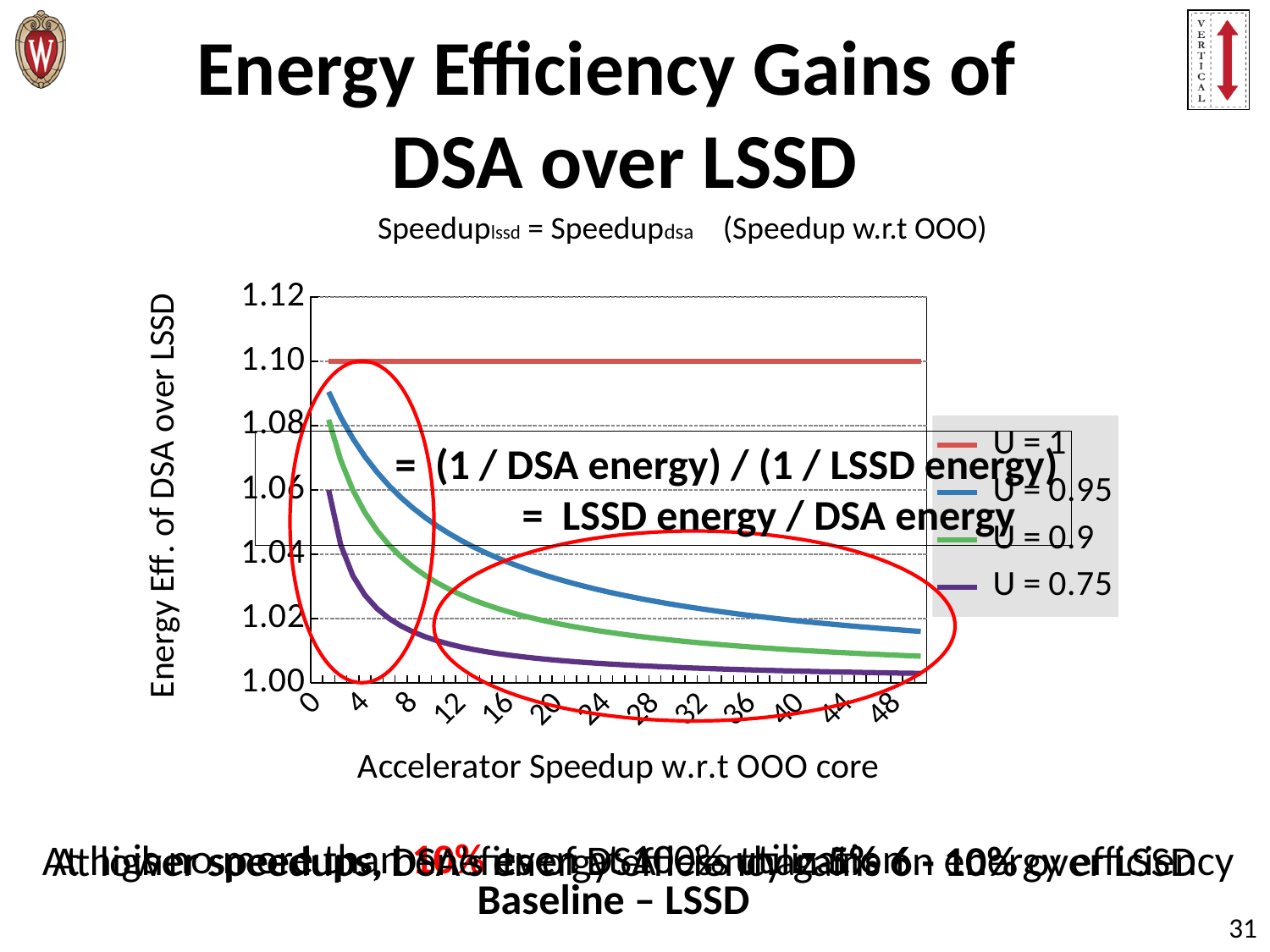
Does the U = 0.95 series rise or fall as accelerator speedup increases? fall Is the value for U = 0.75 at a speedup of 16 greater or less than 1.02? less What is the label of the y axis? Energy Eff. of DSA over LSSD At a speedup of 20, which series has the higher value, U = 0.95 or U = 0.9? U = 0.95 Which series has the lowest energy efficiency across all speedups? U = 0.75 Which series has the highest energy efficiency across all speedups? U = 1 What is the label of the x axis? Accelerator Speedup w.r.t OOO core What kind of chart is shown on the slide? line chart What is the energy efficiency value of the U = 1 series? 1.10 How many series does the legend list? 4 Is the value for U = 0.95 at a speedup of 48 greater or less than 1.02? less Is the value for U = 0.95 at a speedup of 8 greater or less than 1.04? greater